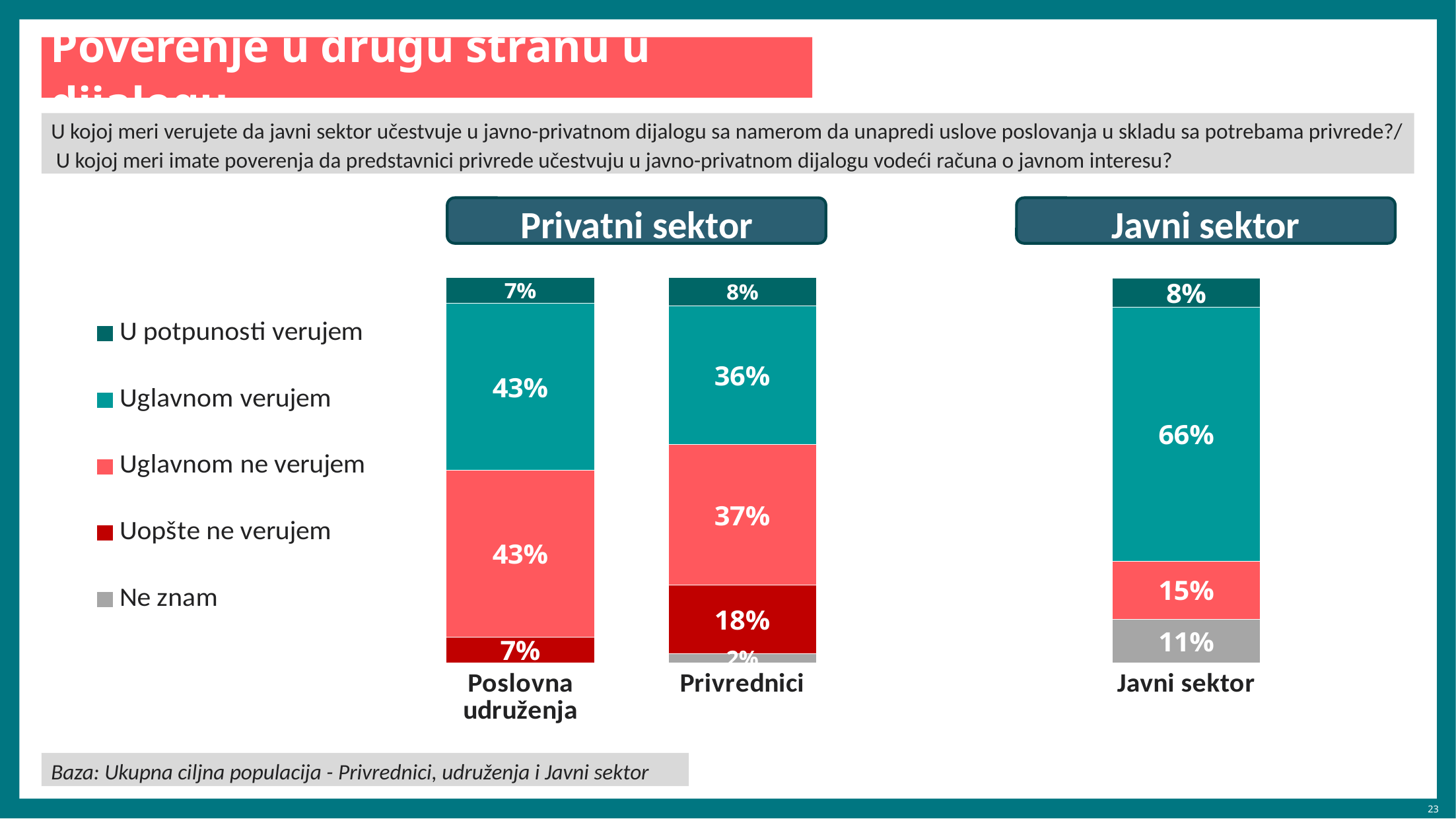
How many percentage points higher is the "Uglavnom verujem" share for Javni sektor than for Privrednici? 30 percentage points How many response categories does the legend list? 5 What percentage of Javni sektor respondents answered "Uglavnom verujem"? 66% Which group has the lowest "Uglavnom ne verujem" share? Javni sektor Which group has the larger "Uopšte ne verujem" share, Privrednici or Poslovna udruženja? Privrednici Which group has the highest "Uglavnom verujem" share? Javni sektor What is the "Uglavnom ne verujem" value for Poslovna udruženja? 43% How many groups (bars) are shown in the chart? 3 What is the "Ne znam" value for Javni sektor? 11% What is the total of the "U potpunosti verujem" and "Uglavnom verujem" segments for Poslovna udruženja? 50% What type of chart is shown on the slide? Stacked bar chart What is the "Uopšte ne verujem" value for Privrednici? 18%